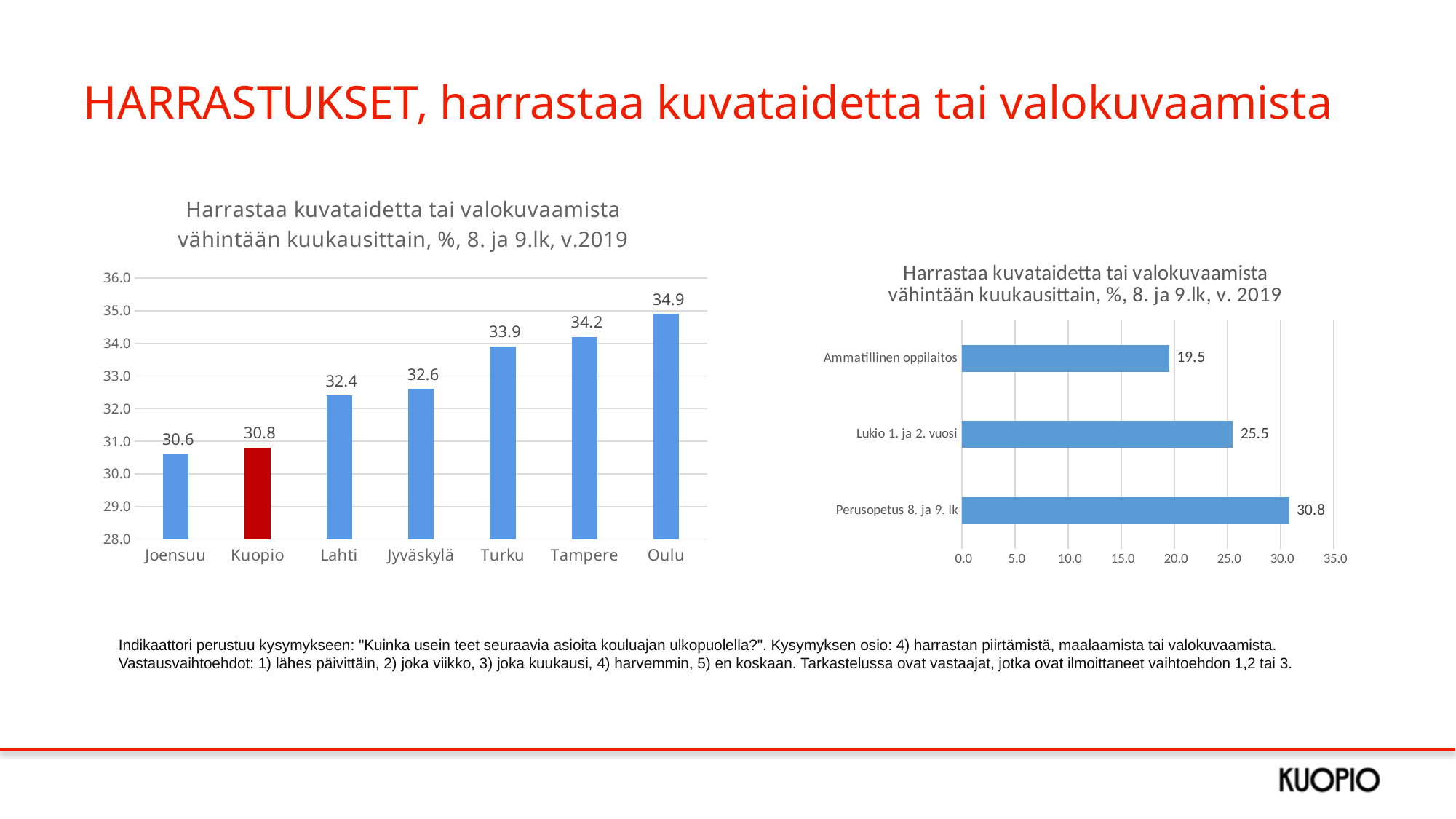
In the right chart (school types), what is the value for Ammatillinen oppilaitos? 19.5 In the left chart (cities), what is the value for Turku? 33.9 In the left chart (cities), what is the difference between Oulu and Joensuu? 4.3 In the left chart (cities), which city has the highest value? Oulu In the right chart (school types), what is the difference between Perusopetus 8. ja 9. lk and Lukio 1. ja 2. vuosi? 5.3 In the right chart (school types), which category has the highest value? Perusopetus 8. ja 9. lk In the left chart (cities), which city has the lowest value? Joensuu In the left chart (cities), which bar is coloured red instead of blue? Kuopio In the left chart (cities), do the values generally rise or fall from Joensuu to Oulu? rise In the left chart (cities), how many cities are shown? 7 In the left chart (cities), which is larger, the value for Lahti or the value for Tampere? Tampere In the left chart (cities), what is the value for Kuopio? 30.8